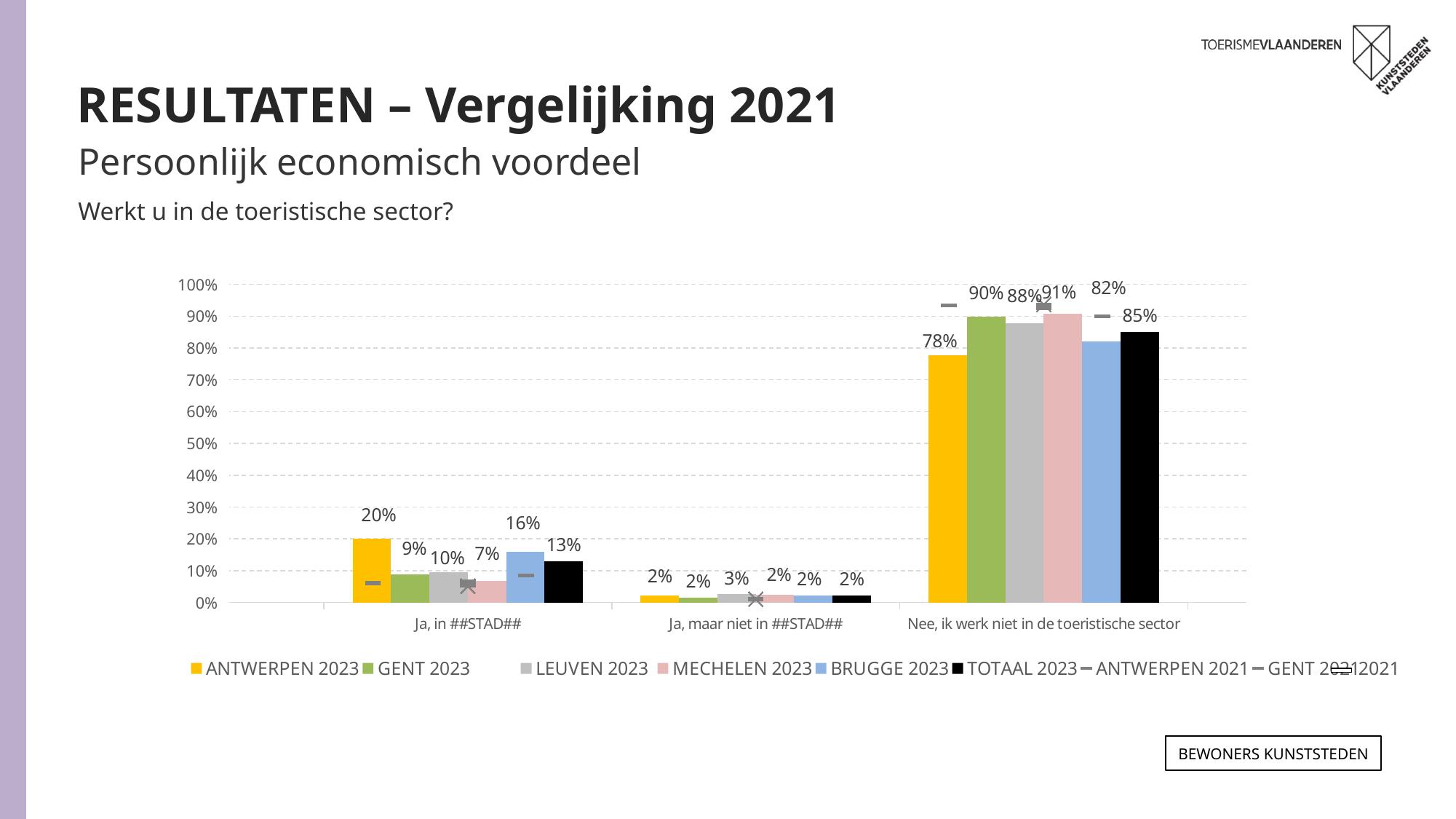
What is the difference between ANTWERPEN 2023 and GENT 2023 in the category "Ja, in ##STAD##"? 11% What is the difference between MECHELEN 2023 and ANTWERPEN 2023 in the category "Nee, ik werk niet in de toeristische sector"? 13% What is the value for LEUVEN 2023 in the category "Ja, maar niet in ##STAD##"? 3% What is the value for ANTWERPEN 2023 in the category "Ja, in ##STAD##"? 20% What is the value for TOTAAL 2023 in the category "Ja, in ##STAD##"? 13% What colour are the bars for TOTAAL 2023? black What kind of chart is shown on the slide? bar chart Which 2023 series has the highest value in the category "Nee, ik werk niet in de toeristische sector"? MECHELEN 2023 In the category "Nee, ik werk niet in de toeristische sector", which is larger: GENT 2023 or TOTAAL 2023? GENT 2023 Which 2023 series has the lowest value in the category "Ja, in ##STAD##"? MECHELEN 2023 What is the value for BRUGGE 2023 in the category "Nee, ik werk niet in de toeristische sector"? 82% How many categories are shown on the x axis of the chart? 3